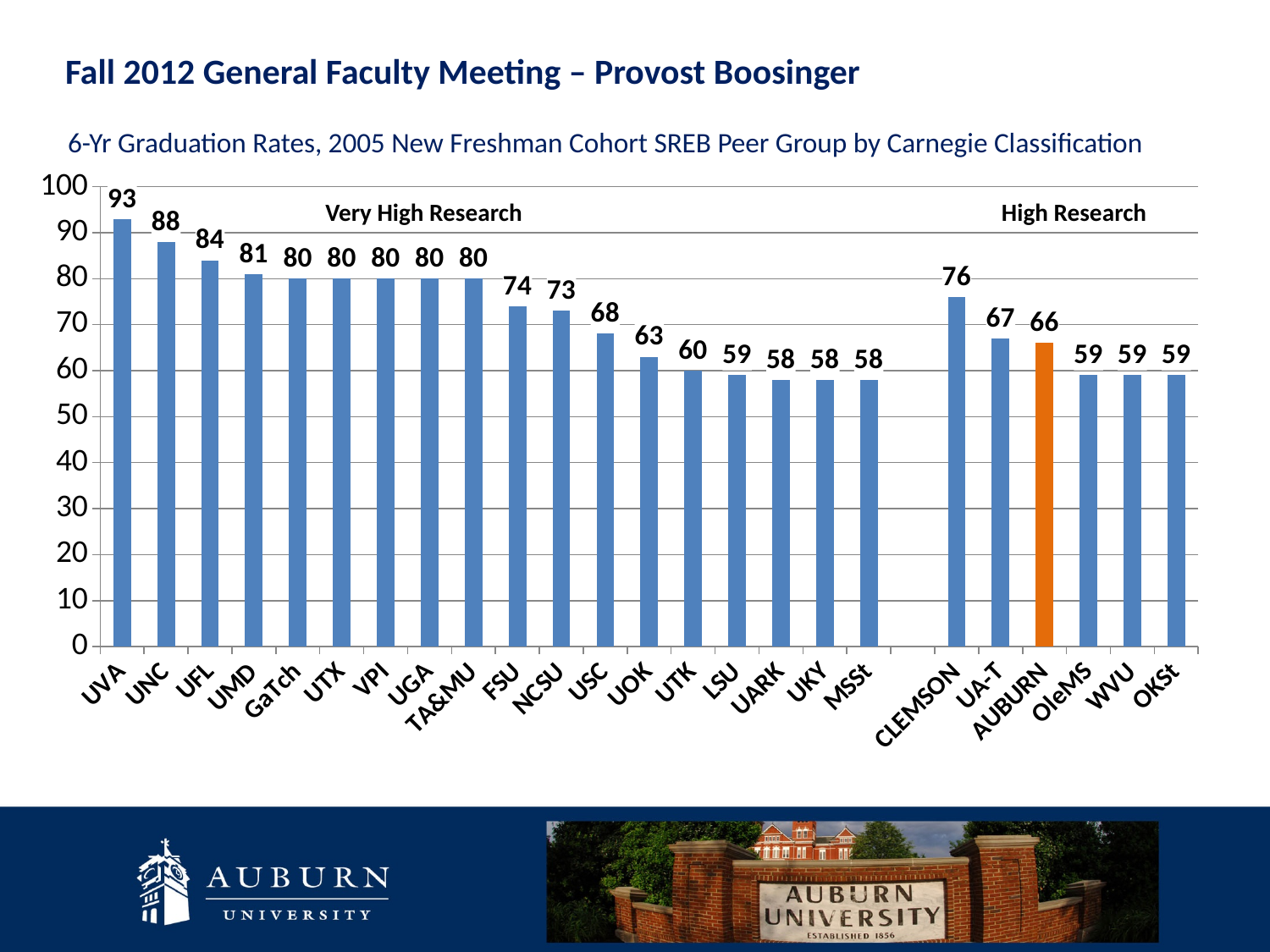
What is the value shown for UVA? 93 Which institution has the highest graduation rate on the chart? UVA What type of chart is shown on the slide? Bar chart Which institution's bar is coloured orange instead of blue? AUBURN Which has a higher value, FSU or USC? FSU What is the 6-year graduation rate shown for AUBURN? 66 What is the value shown for CLEMSON? 76 What is the difference between the values for UVA and AUBURN? 27 What is the lowest graduation rate value shown on the chart? 58 How many institutions are shown on the chart? 24 Which has a higher value, UA-T or AUBURN? UA-T What is the difference between the values for CLEMSON and UA-T? 9